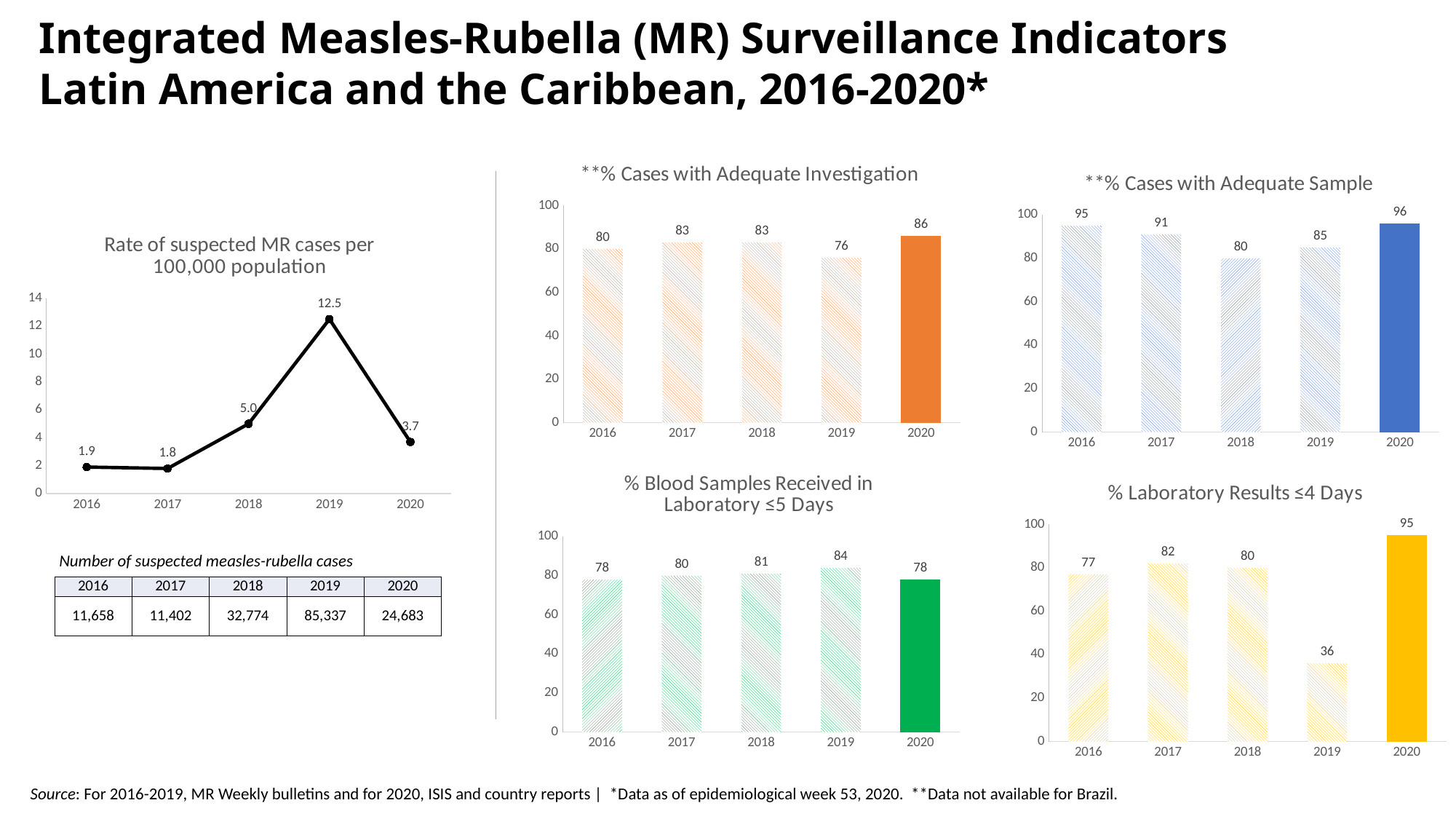
In the '% Blood Samples Received in Laboratory ≤5 Days' chart, what is the value for 2019? 84 In the '% Cases with Adequate Investigation' chart, which year has the highest value? 2020 In the '% Cases with Adequate Investigation' chart, what is the value for 2019? 76 In the '% Blood Samples Received in Laboratory ≤5 Days' chart, how many years are plotted? 5 What kind of chart is '% Laboratory Results ≤4 Days'? bar chart In the '% Laboratory Results ≤4 Days' chart, what is the value for 2019? 36 In the '% Cases with Adequate Sample' chart, what is the difference between the 2020 value and the 2018 value? 16 In the 'Rate of suspected MR cases per 100,000 population' chart, what is the value for 2019? 12.5 What kind of chart is 'Rate of suspected MR cases per 100,000 population'? line chart In the '% Cases with Adequate Sample' chart, which year has the lowest value? 2018 In the '% Laboratory Results ≤4 Days' chart, which is larger, the value for 2017 or the value for 2018? 2017 In the 'Rate of suspected MR cases per 100,000 population' chart, which year has the lowest rate? 2017